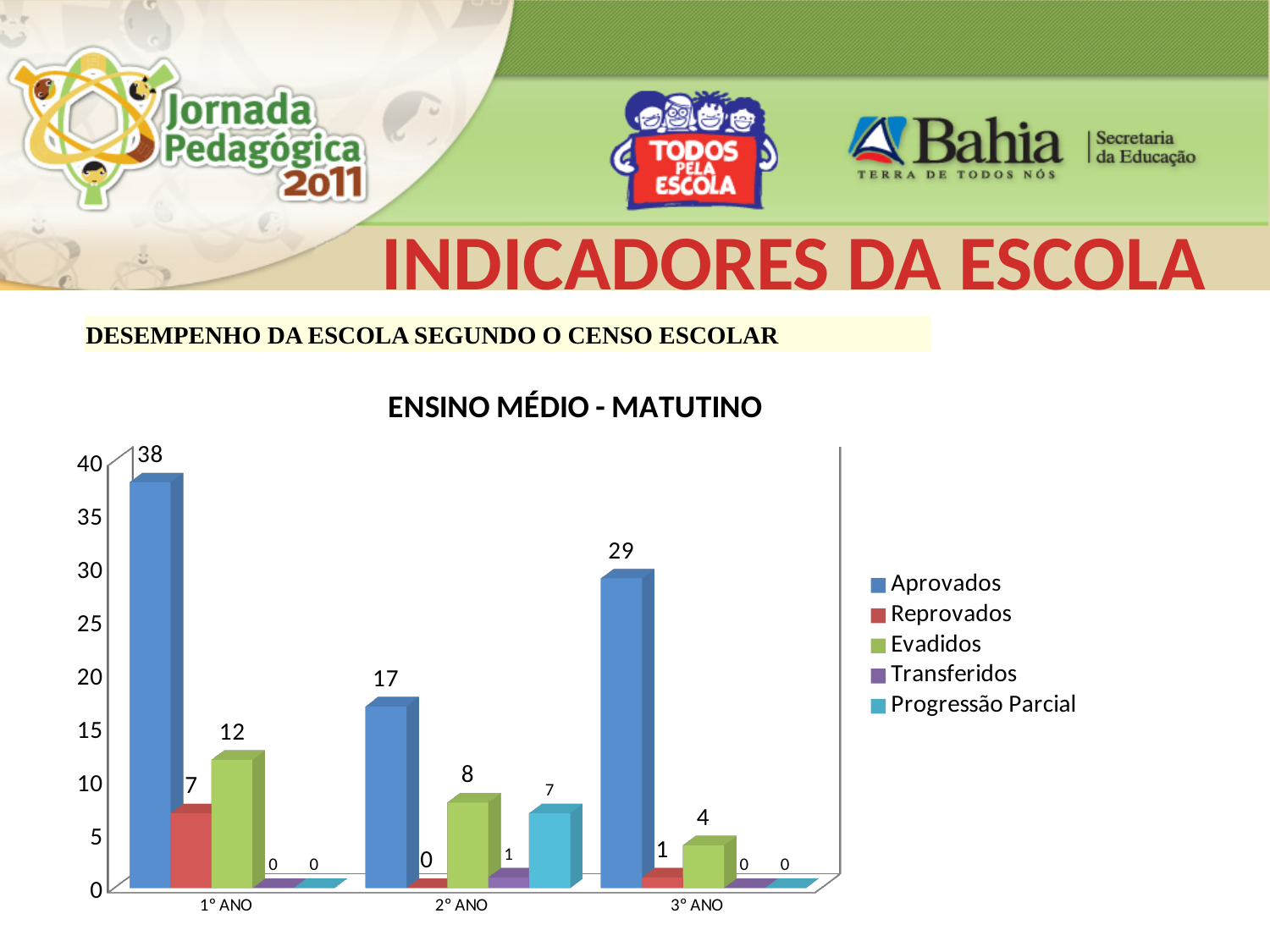
How many year categories are shown on the x axis? 3 Which year has the lowest value for Evadidos? 3° ANO Which year has the highest value for Aprovados? 1° ANO Which is larger: Evadidos in 1° ANO or Reprovados in 1° ANO? Evadidos in 1° ANO What is the difference between Aprovados in 1° ANO and Aprovados in 3° ANO? 9 What is the value for Reprovados in 3° ANO? 1 What kind of chart is this? Bar chart What is the value for Evadidos in 2° ANO? 8 What is the title of the chart? ENSINO MÉDIO - MATUTINO How many series does the legend list? 5 What is the value for Aprovados in 1° ANO? 38 What is the value for Progressão Parcial in 2° ANO? 7